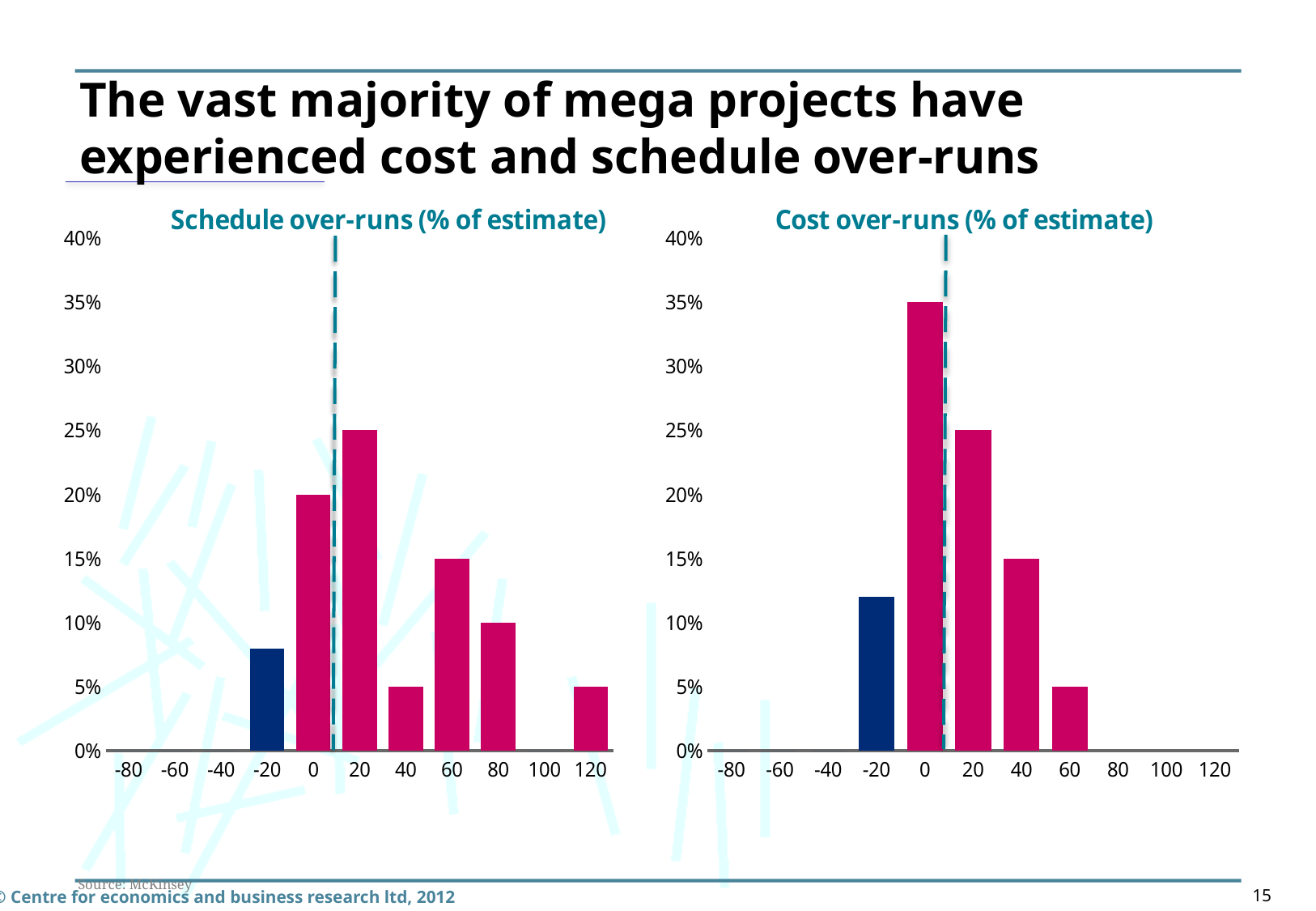
In the Schedule over-runs chart, is the value of the bar at -20 greater or less than 10%? less In the Schedule over-runs chart, what is the value of the bar at 0? 20% In the Cost over-runs chart, what is the value of the bar at 40? 15% In the Cost over-runs chart, which x-axis category has the highest bar? 0 In the Schedule over-runs chart, what is the value of the bar at 20? 25% In the Cost over-runs chart, what is the difference between the bars at 0 and 20? 10% How many bars are plotted in the Schedule over-runs chart? 7 In the Cost over-runs chart, which x-axis category has the lowest bar? 60 What type of chart is the Cost over-runs chart? Bar chart In the Cost over-runs chart, is the value of the bar at -20 greater or less than 10%? greater In the Schedule over-runs chart, which x-axis category has the highest bar? 20 In the Cost over-runs chart, what is the value of the bar at 0? 35%